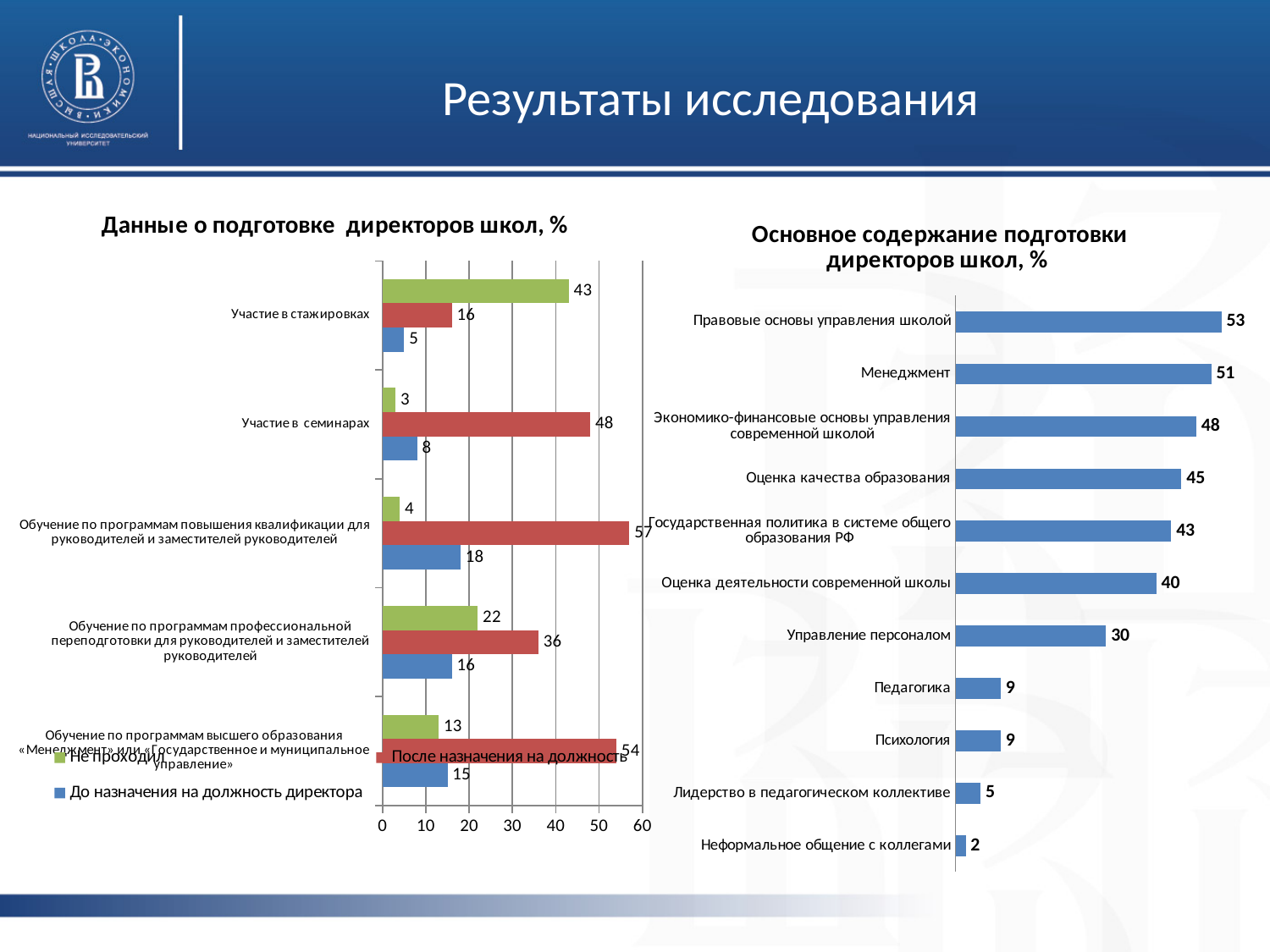
In the chart 'Данные о подготовке директоров школ, %', how many series does the legend list? 3 In the chart 'Данные о подготовке директоров школ, %', what colour are the bars for 'Не проходил'? Green In the chart 'Основное содержание подготовки директоров школ, %', how many categories are shown? 11 In the chart 'Данные о подготовке директоров школ, %', what is the value of 'После назначения на должность' for 'Участие в семинарах'? 48 In the chart 'Данные о подготовке директоров школ, %', what is the difference between 'После назначения на должность' and 'До назначения на должность директора' for 'Участие в стажировках'? 11 In the chart 'Основное содержание подготовки директоров школ, %', which category has the highest value? Правовые основы управления школой In the chart 'Данные о подготовке директоров школ, %', which is larger for 'Обучение по программам профессиональной переподготовки для руководителей и заместителей руководителей': 'Не проходил' or 'До назначения на должность директора'? Не проходил What type of chart is 'Данные о подготовке директоров школ, %'? Bar chart In the chart 'Основное содержание подготовки директоров школ, %', what is the value for 'Менеджмент'? 51 In the chart 'Основное содержание подготовки директоров школ, %', what is the difference between 'Оценка качества образования' and 'Управление персоналом'? 15 In the chart 'Основное содержание подготовки директоров школ, %', which category has the lowest value? Неформальное общение с коллегами In the chart 'Данные о подготовке директоров школ, %', what is the value of 'Не проходил' for 'Участие в стажировках'? 43